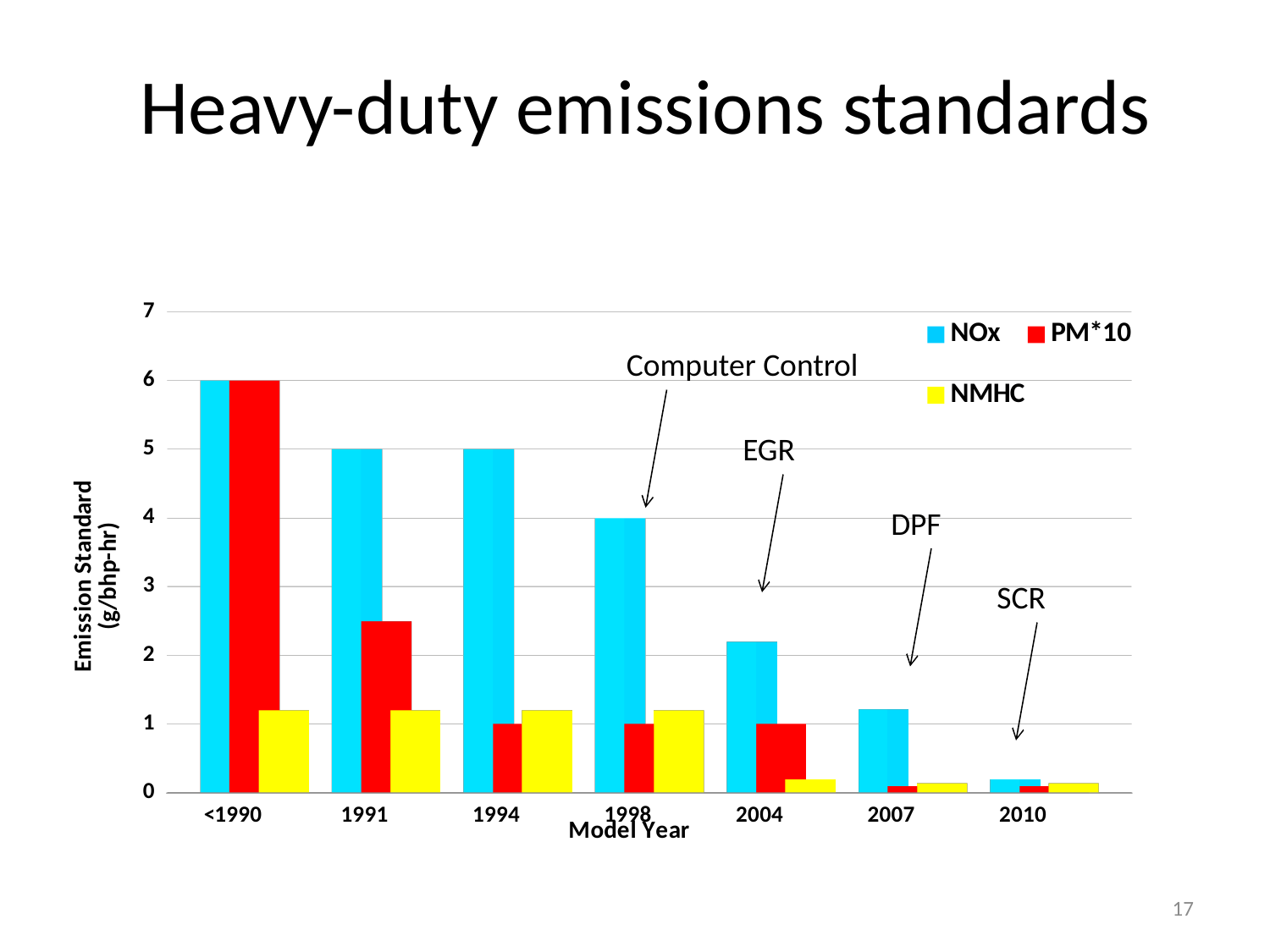
What is the PM*10 value for model year 1994? 1 What is the difference between the NOx standard for <1990 and for 1998? 2 What is the NOx emission standard for model year 1998? 4 How many series does the legend list? 3 How many model year categories are shown on the x axis? 7 Which model year has the highest NOx emission standard? <1990 What kind of chart is shown on the slide? bar chart Which is larger, the PM*10 value for 1991 or the PM*10 value for 1994? 1991 Do the NOx values rise or fall as the model year increases along the x axis? fall What is the NOx emission standard for model year <1990? 6 Which model year has the lowest NOx emission standard? 2010 Is the NOx value for model year 2004 greater or less than 3? less